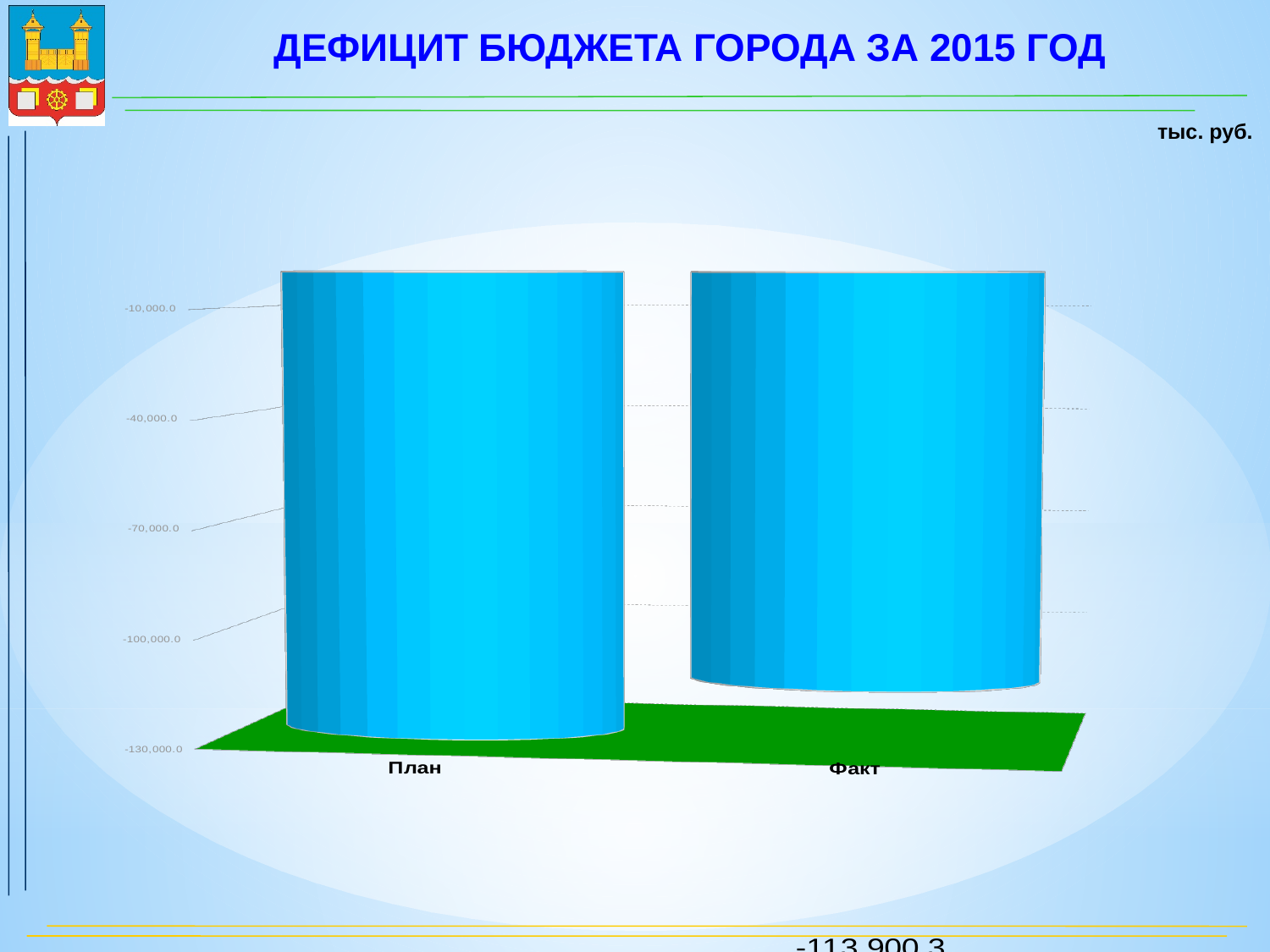
Which category has the lowest (most negative) value on the chart? План What kind of chart is shown on the slide? bar chart How many categories are plotted on the chart? 2 What are the two category labels on the x axis of the chart? План and Факт Is the value for Факт greater or less than -130,000? greater What is the title of the slide containing the chart? ДЕФИЦИТ БЮДЖЕТА ГОРОДА ЗА 2015 ГОД Do the values fall or rise from План to Факт along the x axis? rise Is the value for План greater or less than -100,000? less What is the lowest tick label shown on the vertical axis? -130,000.0 Which category shows the larger budget deficit (the bar extending further down), План or Факт? План Is the value for Факт greater or less than -100,000? less Which category has the highest (least negative) value on the chart? Факт